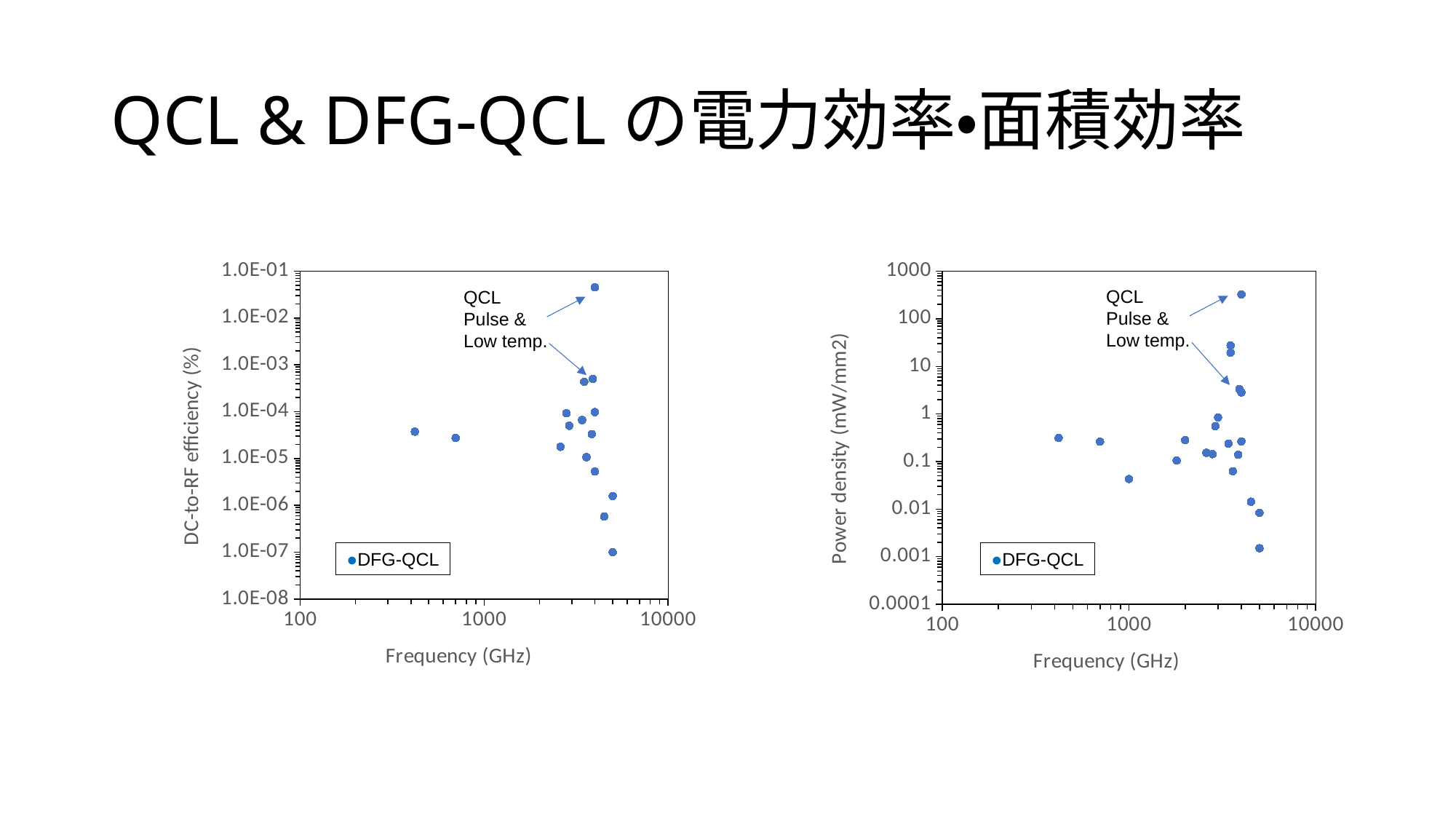
What kind of chart is the right chart (Power density vs Frequency)? scatter chart How many series does the legend of the left chart list? 1 In the right chart, is the highest plotted power density value greater or less than 100? greater What is the series name shown in the legend of the right chart? DFG-QCL In the right chart, is the power density of the point plotted near 400 GHz greater or less than 1? less In the right chart, is the power density of the point plotted near 1000 GHz greater or less than 0.1? less What is the y-axis label of the right chart? Power density (mW/mm2) What kind of chart is the left chart (DC-to-RF efficiency vs Frequency)? scatter chart